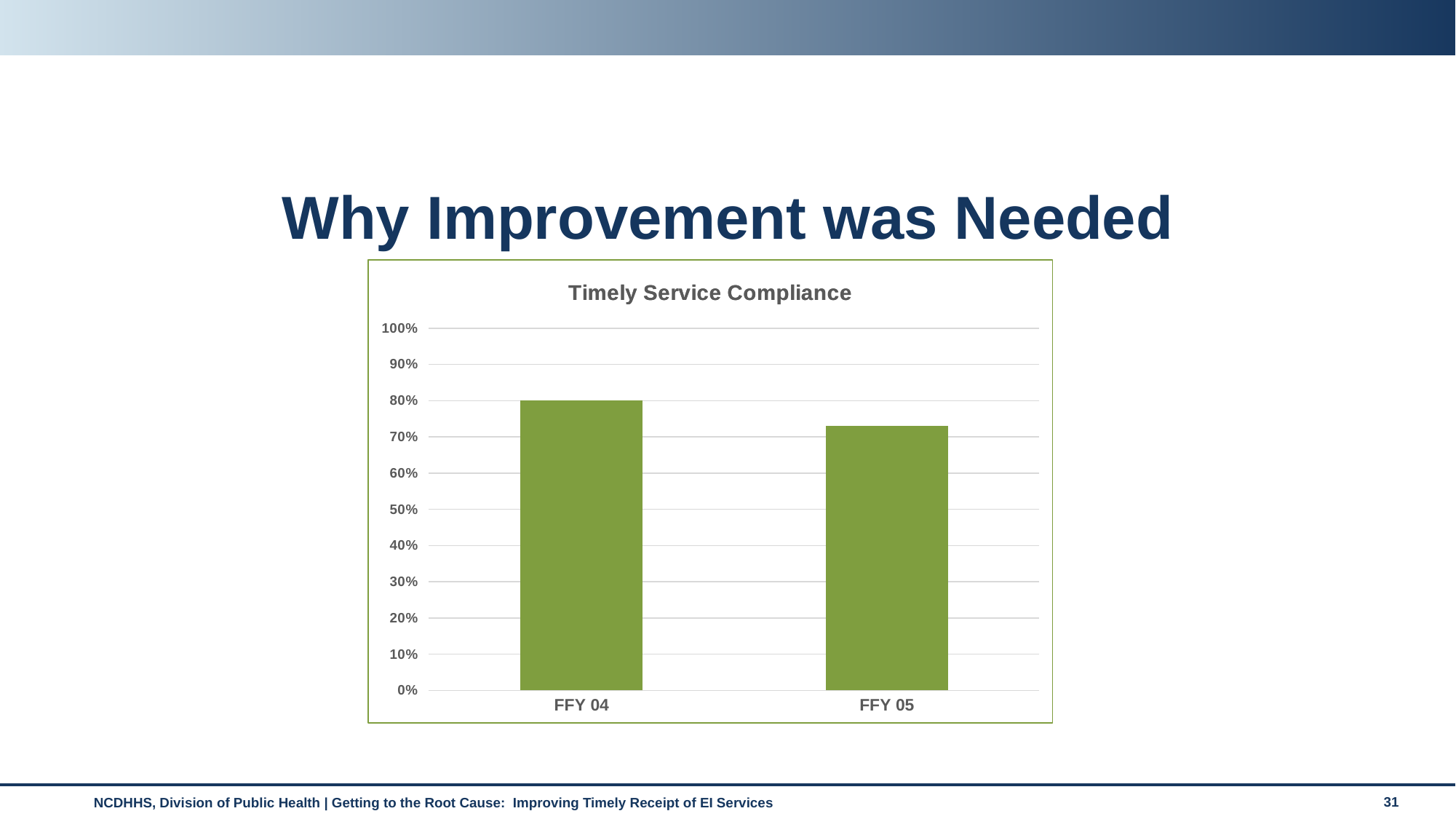
Do the values rise or fall from FFY 04 to FFY 05? fall Which is larger, the value for FFY 04 or the value for FFY 05? FFY 04 What is the value for FFY 04? 80% What is the title of the chart? Timely Service Compliance Is the value for FFY 05 greater or less than 70%? greater What kind of chart is shown on the slide? bar chart Is the value for FFY 04 greater or less than 50%? greater How many categories are plotted on the x axis? 2 Which category has the highest value? FFY 04 Is the value for FFY 05 greater or less than 80%? less Which category has the lowest value? FFY 05 What is the highest value shown on the y axis? 100%